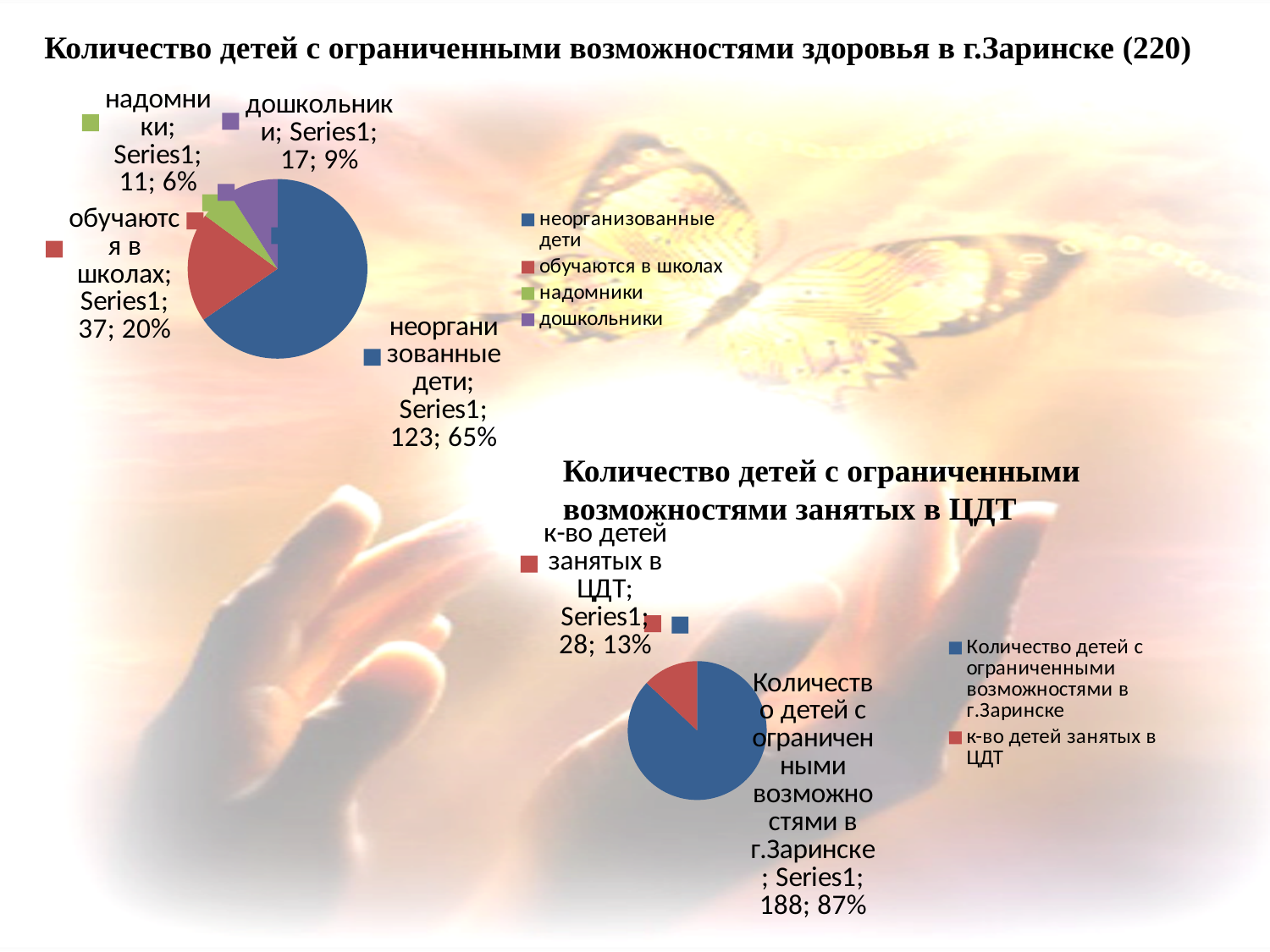
In the bottom-right pie chart, what percentage share is shown for Количество детей с ограниченными возможностями в г.Заринске? 87% In the top-left pie chart, what percentage share is shown for обучаются в школах? 20% In the bottom-right pie chart, which is larger: Количество детей с ограниченными возможностями в г.Заринске or к-во детей занятых в ЦДТ? Количество детей с ограниченными возможностями в г.Заринске In the top-left pie chart, what is the difference between the values for неорганизованные дети and обучаются в школах? 86 In the bottom-right pie chart, what value is shown for к-во детей занятых в ЦДТ? 28 What type of chart is the bottom-right chart (Количество детей с ограниченными возможностями занятых в ЦДТ)? pie chart In the top-left pie chart, which category has the largest slice? неорганизованные дети In the top-left pie chart (Количество детей с ограниченными возможностями здоровья в г.Заринске), what value is shown for неорганизованные дети? 123 In the top-left pie chart, what value is shown for надомники? 11 In the top-left pie chart, which category has the smallest slice? надомники In the top-left pie chart, what percentage share is shown for дошкольники? 9% How many categories does the top-left pie chart have? 4